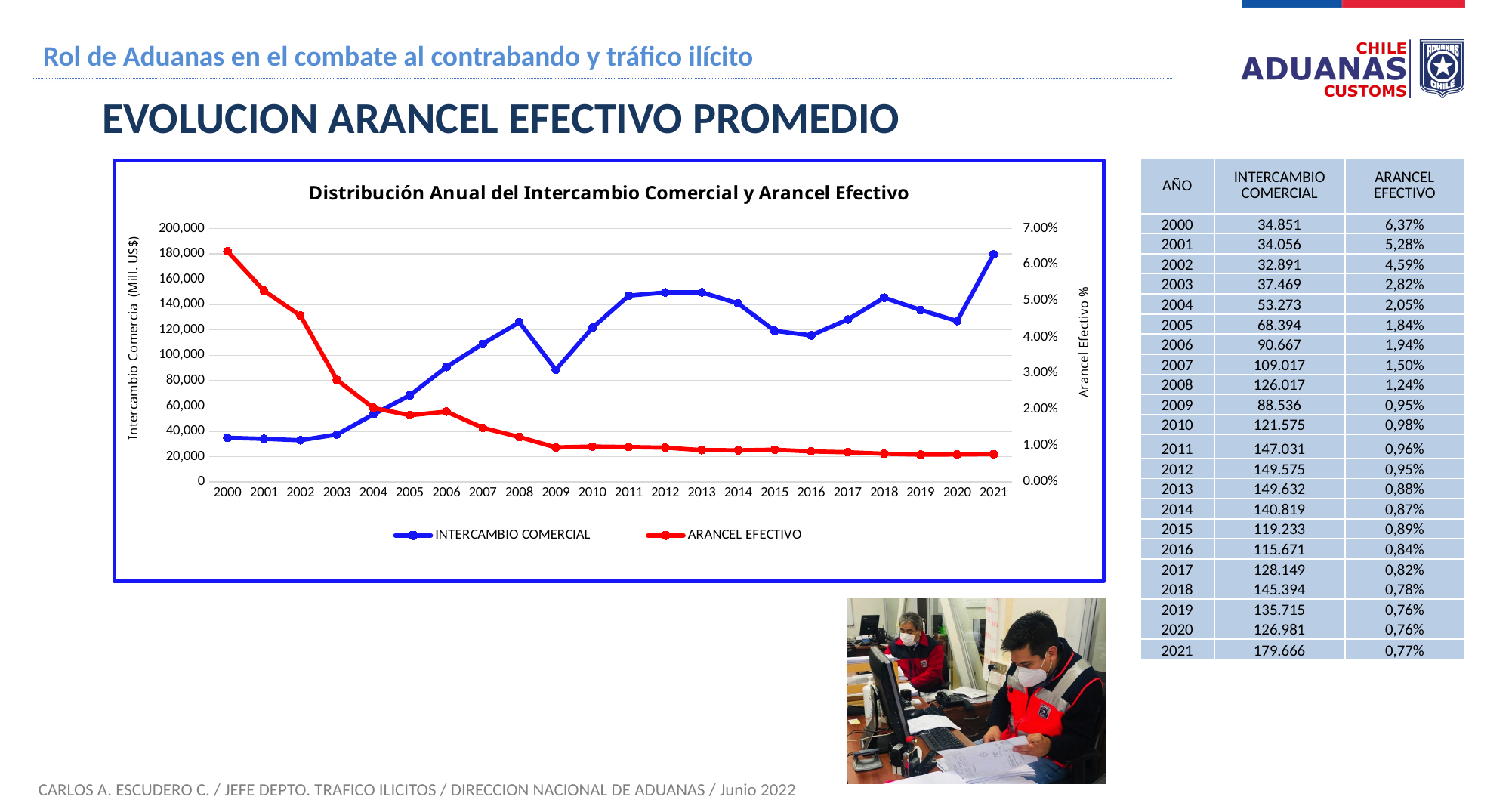
What colour is the ARANCEL EFECTIVO line in the chart? red What kind of chart is 'Distribución Anual del Intercambio Comercial y Arancel Efectivo'? line chart How many series does the legend of the chart list? 2 In which year is ARANCEL EFECTIVO highest? 2000 In which year is INTERCAMBIO COMERCIAL highest? 2021 Is the INTERCAMBIO COMERCIAL value for 2009 greater or less than 100,000? less What is the difference between the ARANCEL EFECTIVO values for 2000 and 2001? 1,09% Which year has the larger INTERCAMBIO COMERCIAL value, 2008 or 2009? 2008 How many years are plotted along the x axis of the chart? 22 What is the INTERCAMBIO COMERCIAL value for 2021? 179.666 What is the ARANCEL EFECTIVO value for 2000? 6,37% Does ARANCEL EFECTIVO generally rise or fall from 2000 to 2021? fall